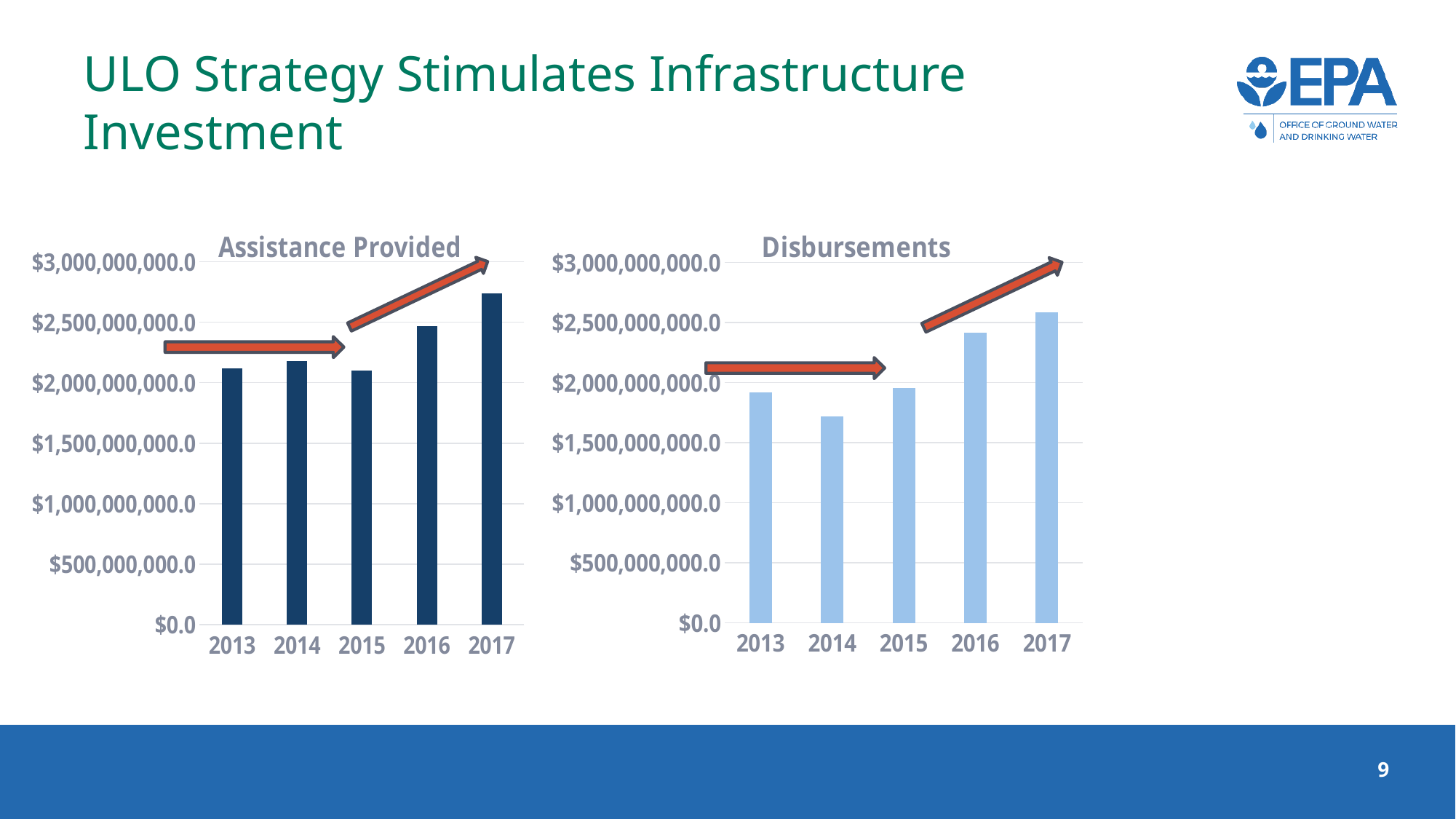
In the Disbursements chart, which is larger, the value for 2016 or the value for 2013? 2016 In the Disbursements chart, which year has the highest value? 2017 In the Disbursements chart, do the values rise or fall from 2015 to 2017? rise What is the title of the chart on the right side of the slide? Disbursements In the Assistance Provided chart, which year has the highest value? 2017 In the Disbursements chart, which year has the lowest value? 2014 In the Disbursements chart, is the value for 2014 greater or less than $2,000,000,000.0? less In the Assistance Provided chart, which is larger, the value for 2015 or the value for 2016? 2016 In the Assistance Provided chart, is the value for 2013 greater or less than $2,000,000,000.0? greater What kind of chart is the Assistance Provided chart? bar chart In the Assistance Provided chart, is the value for 2017 greater or less than $2,500,000,000.0? greater How many years are shown on the x axis of the Disbursements chart? 5